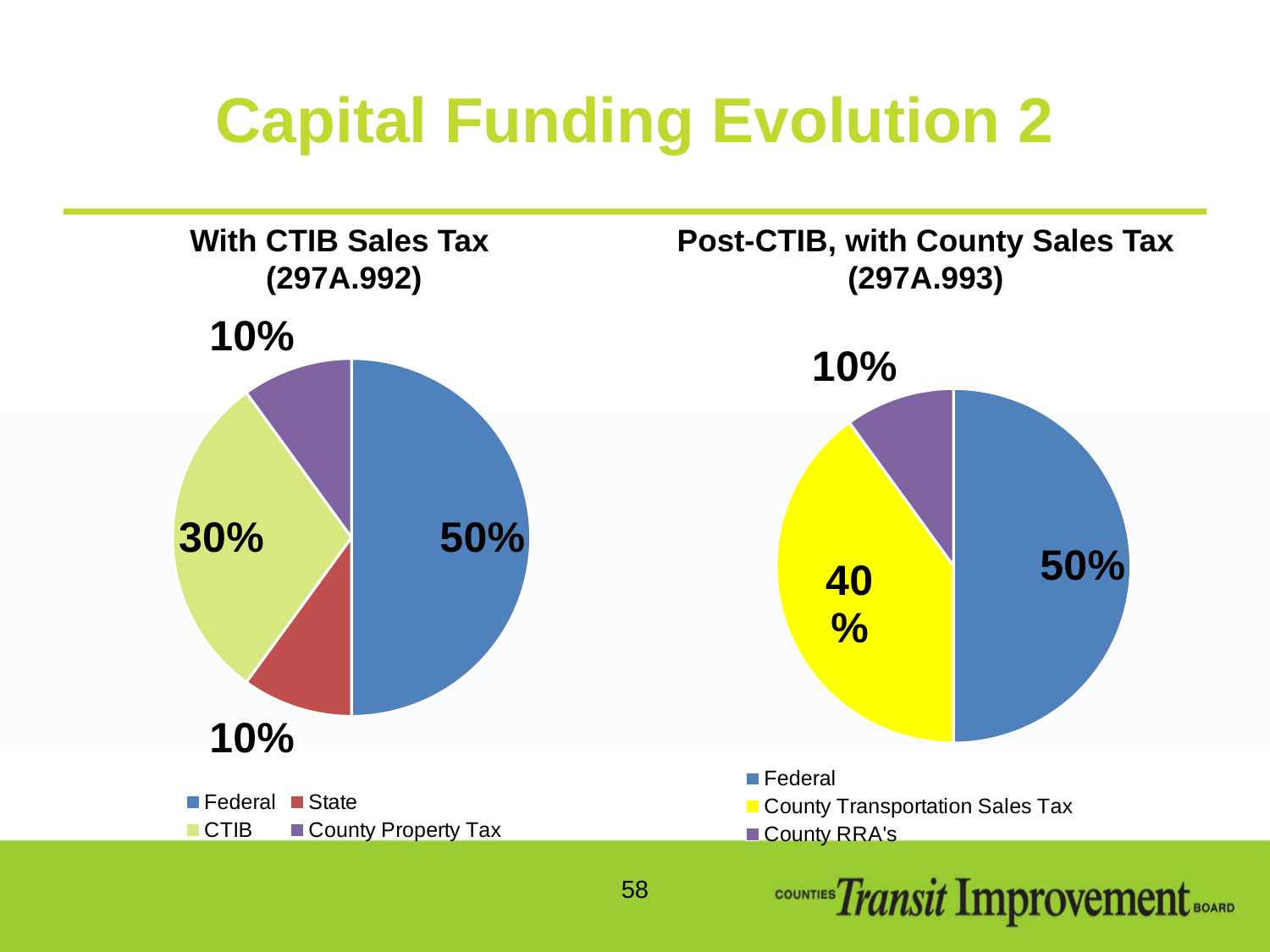
In the 'With CTIB Sales Tax (297A.992)' chart, which category has the largest share? Federal In the 'Post-CTIB, with County Sales Tax (297A.993)' chart, what share does County RRA's have? 10% In the 'Post-CTIB, with County Sales Tax (297A.993)' chart, which category has the smallest share? County RRA's What type of chart is the 'Post-CTIB, with County Sales Tax (297A.993)' chart? Pie chart In the 'With CTIB Sales Tax (297A.992)' chart, what share does Federal have? 50% In the 'Post-CTIB, with County Sales Tax (297A.993)' chart, which is larger: Federal or County Transportation Sales Tax? Federal How many categories does the 'Post-CTIB, with County Sales Tax (297A.993)' chart show? 3 In the 'With CTIB Sales Tax (297A.992)' chart, what share does CTIB have? 30% In the 'With CTIB Sales Tax (297A.992)' chart, what share does State have? 10% In the 'Post-CTIB, with County Sales Tax (297A.993)' chart, what share does County Transportation Sales Tax have? 40% How many categories does the 'With CTIB Sales Tax (297A.992)' chart show? 4 In the 'With CTIB Sales Tax (297A.992)' chart, what is the difference between the Federal share and the CTIB share? 20%